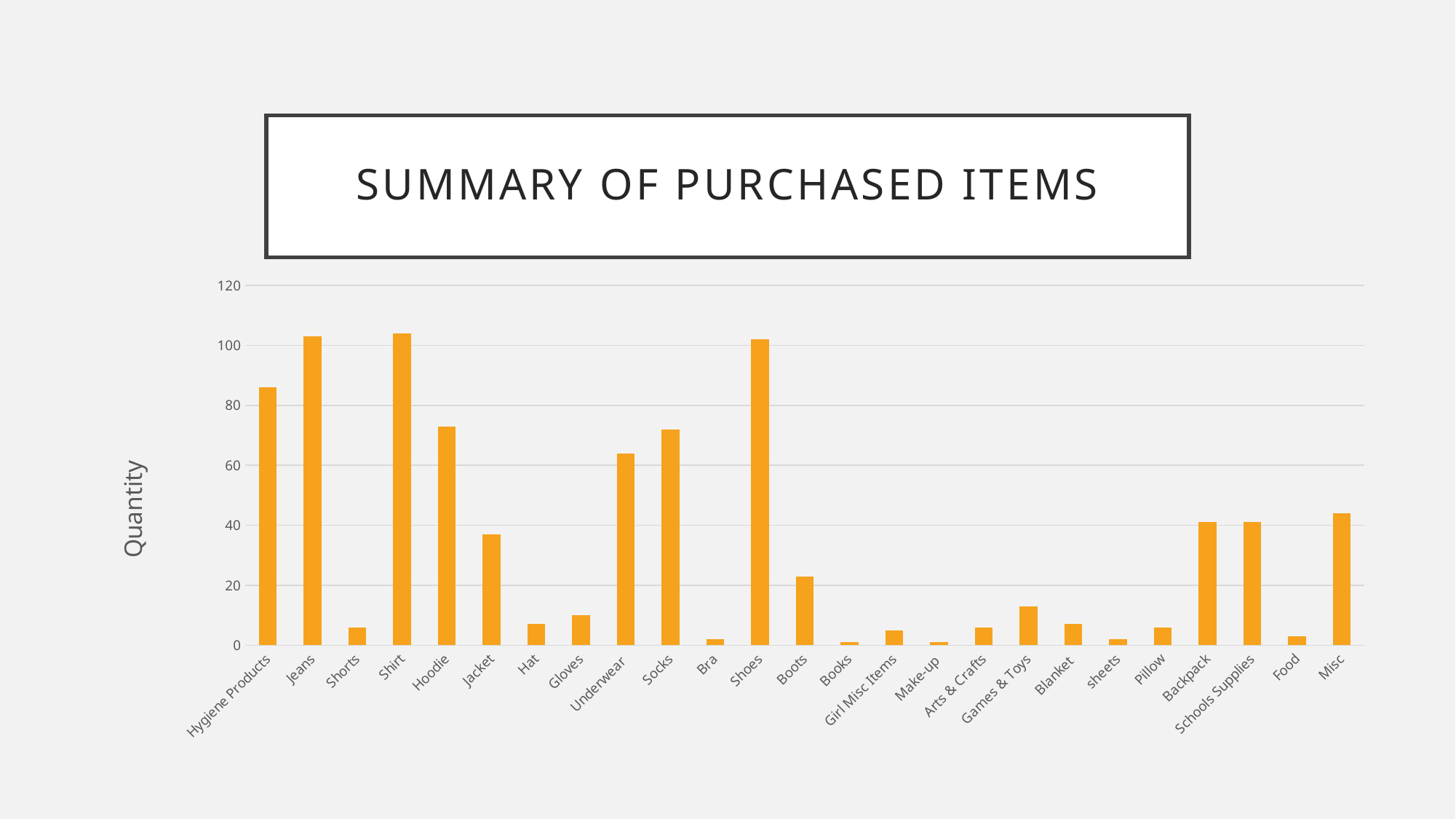
What is the title of the chart on the slide? SUMMARY OF PURCHASED ITEMS Is the value for Jacket greater or less than 40? less Which has a larger value, Hoodie or Jacket? Hoodie How many item categories are shown on the x axis of the chart? 25 Which has a larger value, Boots or Games & Toys? Boots What kind of chart is shown on the slide? Bar chart Is the value for Jeans greater or less than 100? greater Is the value for Shorts greater or less than 20? less What is the label on the vertical axis of the chart? Quantity